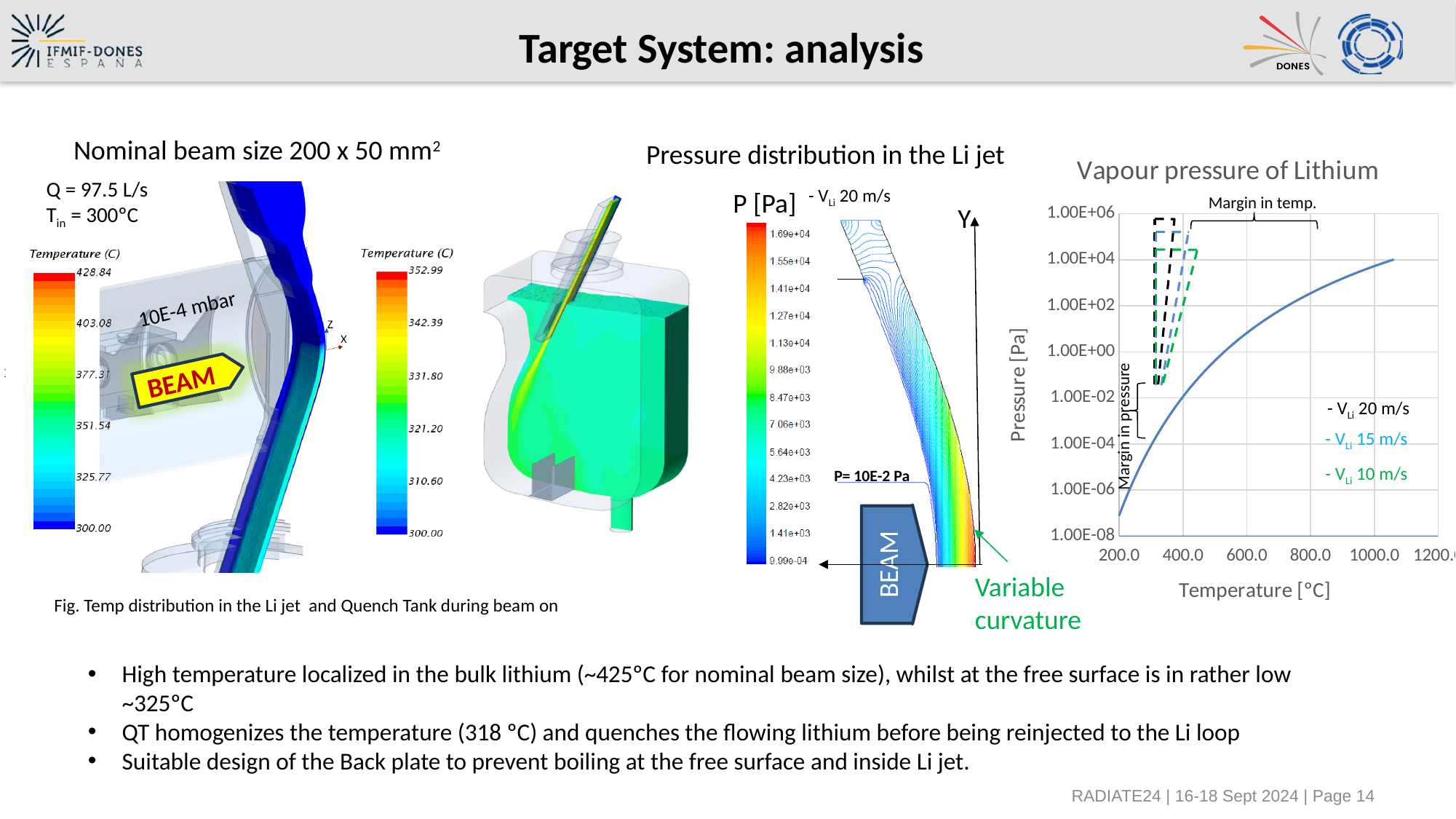
What kind of chart is the 'Vapour pressure of Lithium' chart? line chart In the 'Vapour pressure of Lithium' chart, how many lithium jet velocities (VLi) are listed next to the curve? 3 In the 'Vapour pressure of Lithium' chart, does the vapour pressure rise or fall as temperature increases? rise What is the title of the chart on the right side of the slide? Vapour pressure of Lithium In the 'Vapour pressure of Lithium' chart, is the vapour pressure at 400.0 °C greater or less than 1.00E+00 Pa? less In the 'Vapour pressure of Lithium' chart, what is the label of the x axis? Temperature [°C] In the 'Vapour pressure of Lithium' chart, what is the highest temperature tick shown on the x axis? 1200.0 In the 'Vapour pressure of Lithium' chart, is the vapour pressure at 800.0 °C greater or less than 1.00E+00 Pa? greater In the 'Vapour pressure of Lithium' chart, what is the highest value shown on the pressure axis? 1.00E+06 In the 'Vapour pressure of Lithium' chart, how many temperature tick labels are shown on the x axis? 6 In the 'Vapour pressure of Lithium' chart, which lithium velocity is labelled in green? VLi 10 m/s In the 'Vapour pressure of Lithium' chart, what is the lowest value shown on the pressure axis? 1.00E-08